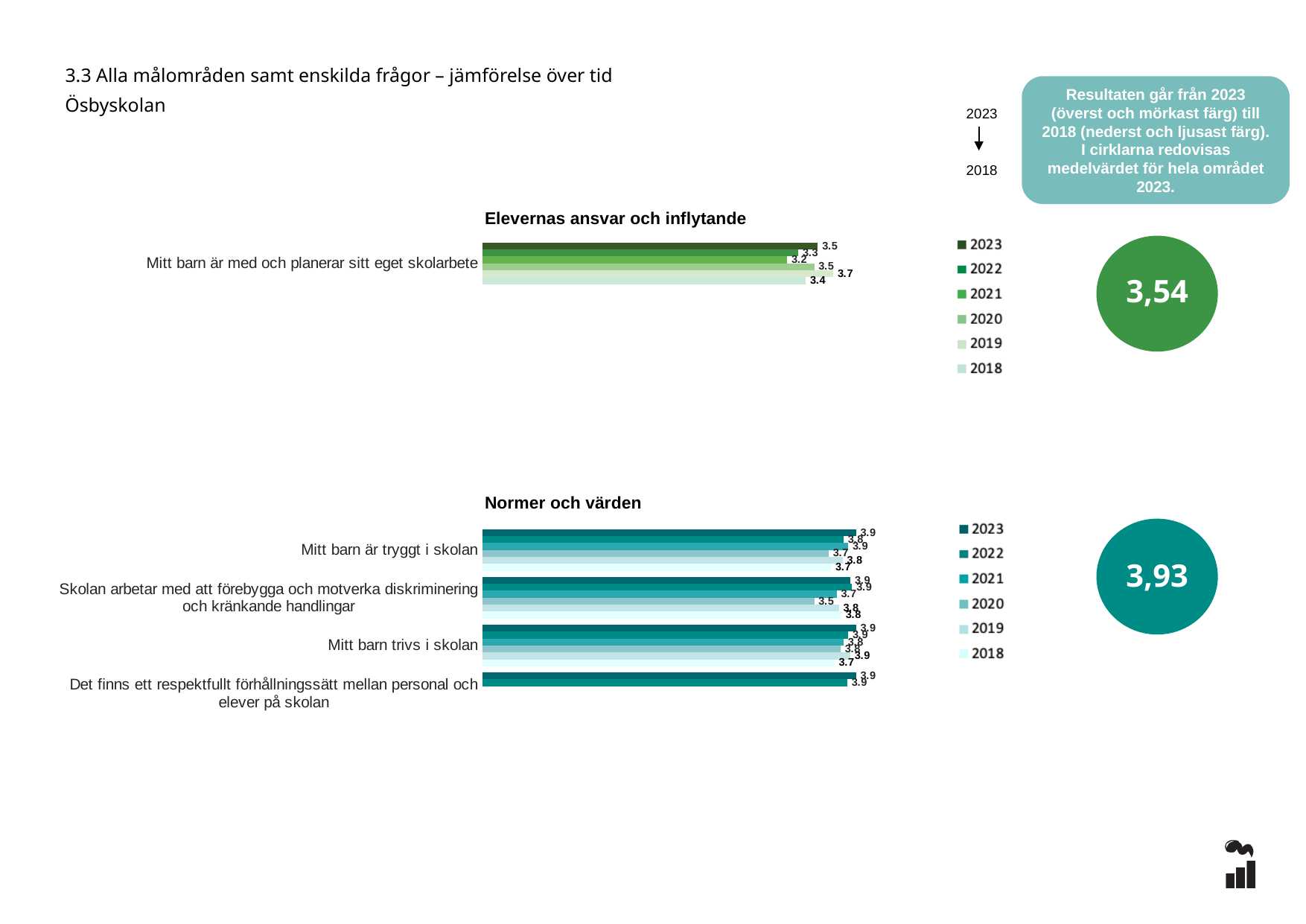
In the chart 'Elevernas ansvar och inflytande', what is the 2019 value for 'Mitt barn är med och planerar sitt eget skolarbete'? 3.7 What mean value for 2023 is shown in the circle next to the chart 'Normer och värden'? 3,93 In the chart 'Normer och värden', which is larger: the 2023 value or the 2020 value for 'Skolan arbetar med att förebygga och motverka diskriminering och kränkande handlingar'? 2023 In the chart 'Elevernas ansvar och inflytande', what is the 2023 value for 'Mitt barn är med och planerar sitt eget skolarbete'? 3.5 What type of chart is 'Normer och värden'? Bar chart In the chart 'Normer och värden', what is the 2018 value for 'Mitt barn är tryggt i skolan'? 3.7 In the chart 'Normer och värden', what is the 2020 value for 'Skolan arbetar med att förebygga och motverka diskriminering och kränkande handlingar'? 3.5 In the chart 'Elevernas ansvar och inflytande', what is the difference between the 2019 and 2021 values for 'Mitt barn är med och planerar sitt eget skolarbete'? 0.5 In the chart 'Elevernas ansvar och inflytande', which year has the lowest value for 'Mitt barn är med och planerar sitt eget skolarbete'? 2021 How many categories are shown in the chart 'Normer och värden'? 4 How many series does the legend of the chart 'Normer och värden' list? 6 In the chart 'Normer och värden', what is the 2023 value for 'Mitt barn trivs i skolan'? 3.9